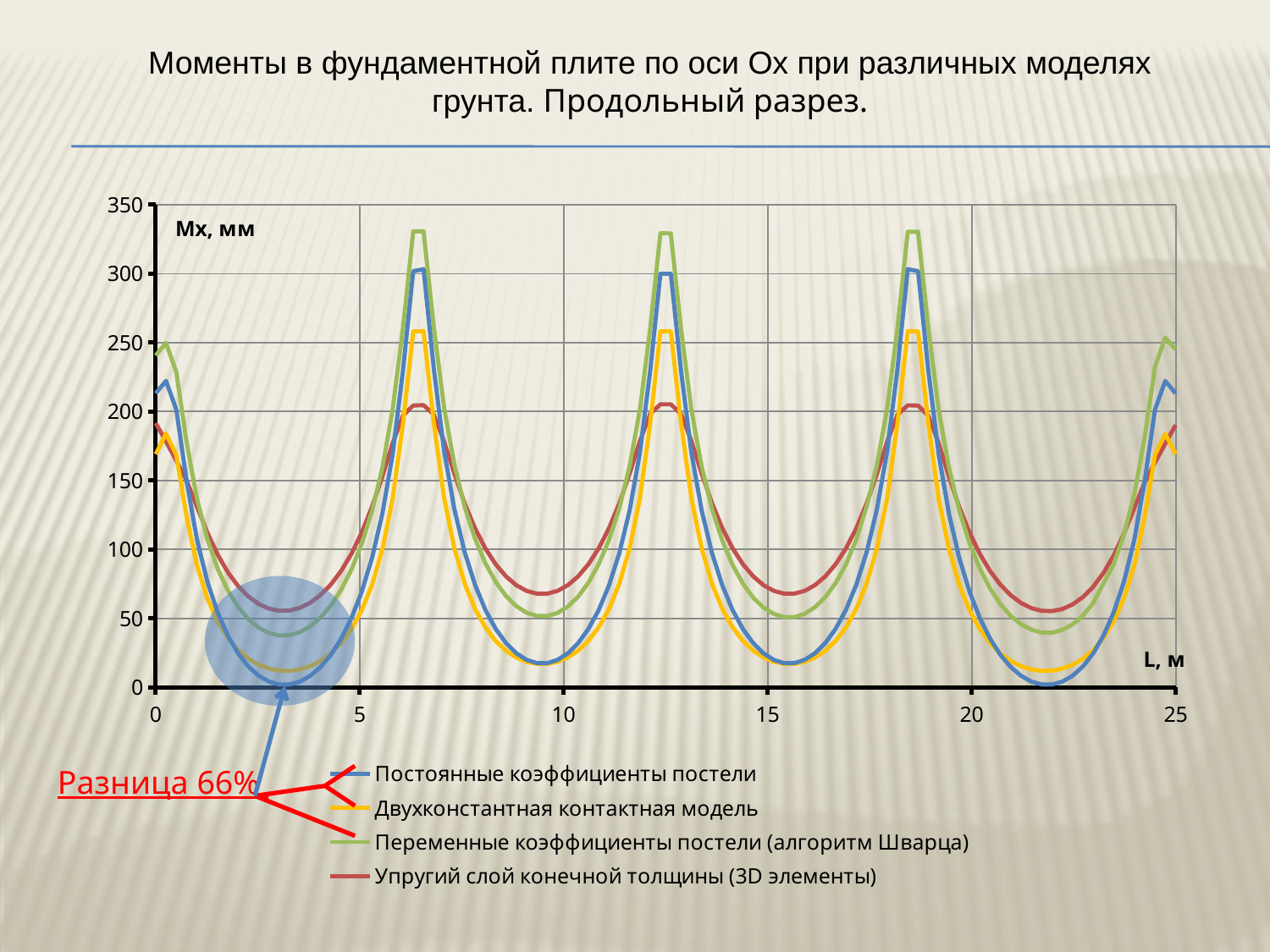
Is the peak value of the 'Упругий слой конечной толщины (3D элементы)' series near L = 12.5 greater or less than 250? less Is the peak value of the 'Переменные коэффициенты постели (алгоритм Шварца)' series near L = 6.5 greater or less than 300? greater What kind of chart is shown on the slide? line chart Which series drops to the lowest value on the chart? Постоянные коэффициенты постели Is the minimum value of the 'Постоянные коэффициенты постели' series near L = 22 greater or less than 50? less Which series reaches the highest peak value on the chart? Переменные коэффициенты постели (алгоритм Шварца) At the peak near L = 18.5, which series is higher: 'Двухконстантная контактная модель' or 'Упругий слой конечной толщины (3D элементы)'? Двухконстантная контактная модель How many series does the legend list? 4 What is the highest tick value shown on the vertical axis? 350 What is the label on the horizontal axis of the chart? L, м What is the label on the vertical axis of the chart? Mx, мм